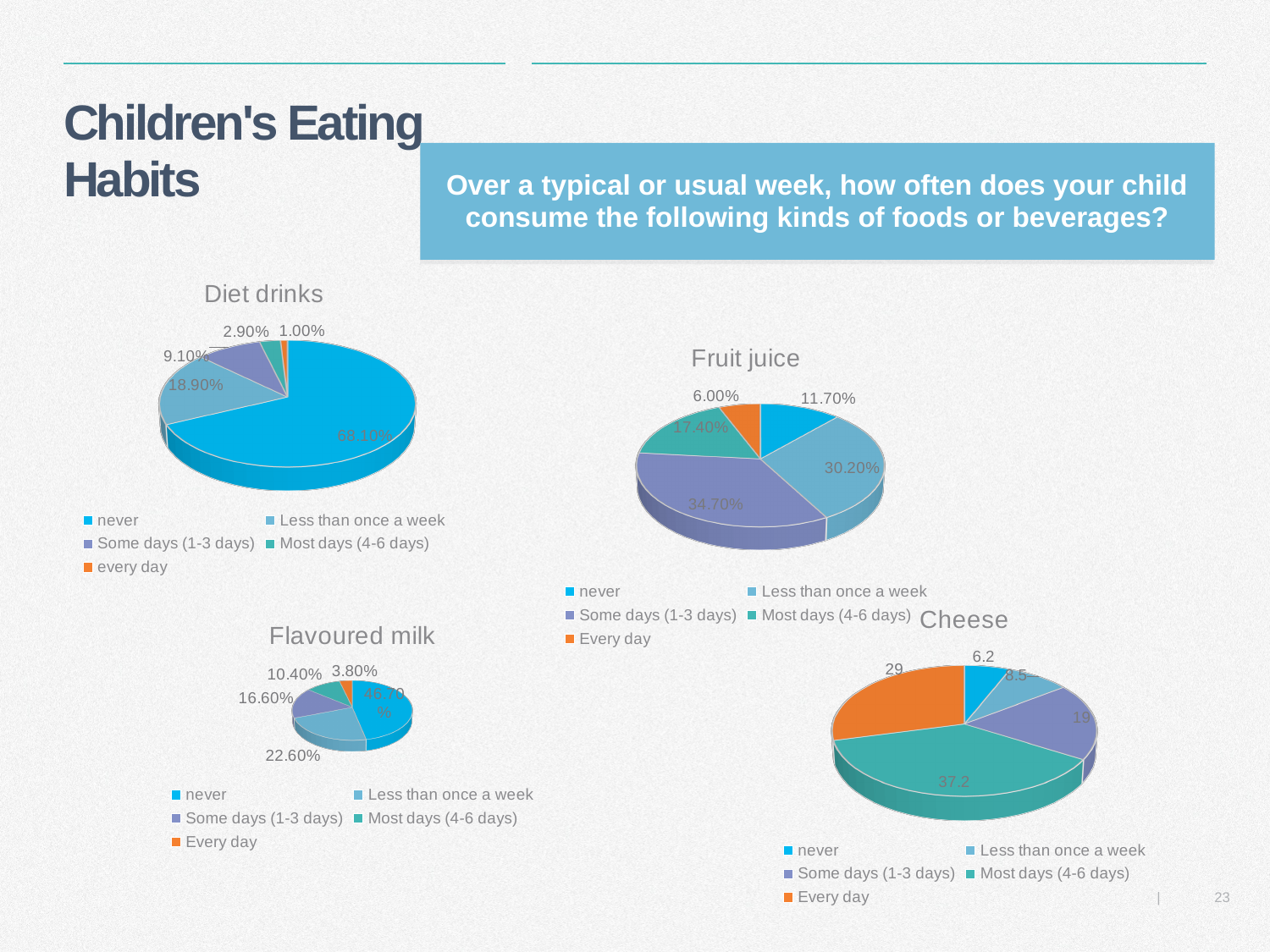
In the Cheese chart, what is the value for 'Every day'? 29 In the Fruit juice chart, which category has the largest share? Some days (1-3 days) How many charts are shown on the slide? 4 In the Diet drinks chart, what is the value for 'every day'? 1.00% In the Flavoured milk chart, which category has the smallest share? Every day In the Fruit juice chart, what is the value for 'Every day'? 6.00% In the Flavoured milk chart, what is the value for 'Less than once a week'? 22.60% In the Fruit juice chart, what is the difference between 'Less than once a week' and 'never'? 18.50% What kind of chart is the Diet drinks chart? Pie chart In the Cheese chart, which category has the largest share? Most days (4-6 days) In the Cheese chart, which is larger: 'Some days (1-3 days)' or 'never'? Some days (1-3 days) In the Diet drinks chart, what percentage of children never consume diet drinks? 68.10%